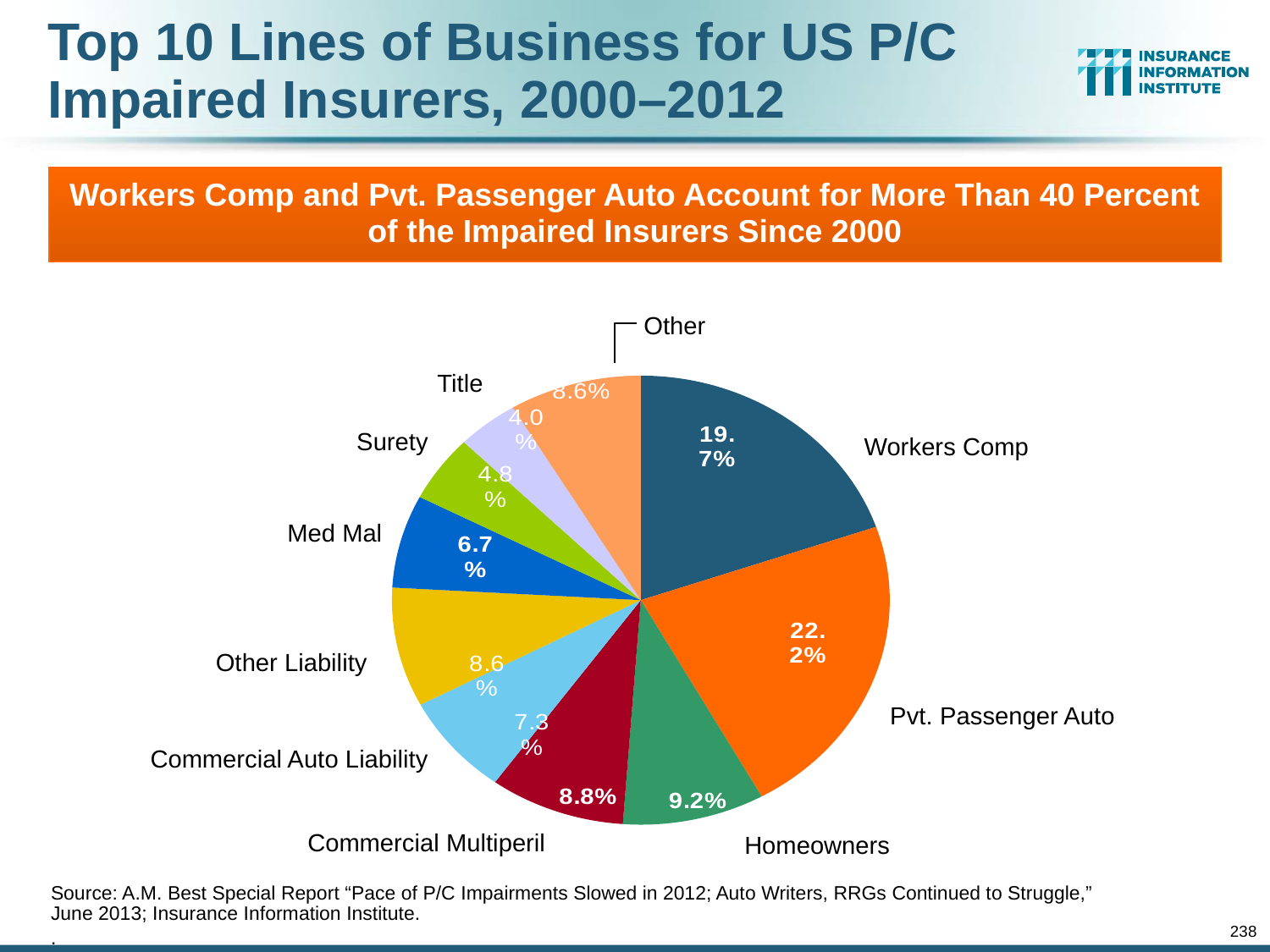
What share of impaired insurers does Pvt. Passenger Auto account for? 22.2% Which line of business has the largest slice of the pie? Pvt. Passenger Auto What is the value shown for Med Mal? 6.7% What is the value shown for Homeowners? 9.2% What is the value shown for Commercial Auto Liability? 7.3% Which line of business has the smallest slice of the pie? Title What is the combined share of Workers Comp and Pvt. Passenger Auto? 41.9% What share of impaired insurers does Workers Comp account for? 19.7% What kind of chart is shown on the slide? pie chart What is the difference in percentage points between Pvt. Passenger Auto and Workers Comp? 2.5 How many lines of business (slices) are shown in the pie chart? 10 Which is larger, the share for Homeowners or the share for Commercial Multiperil? Homeowners